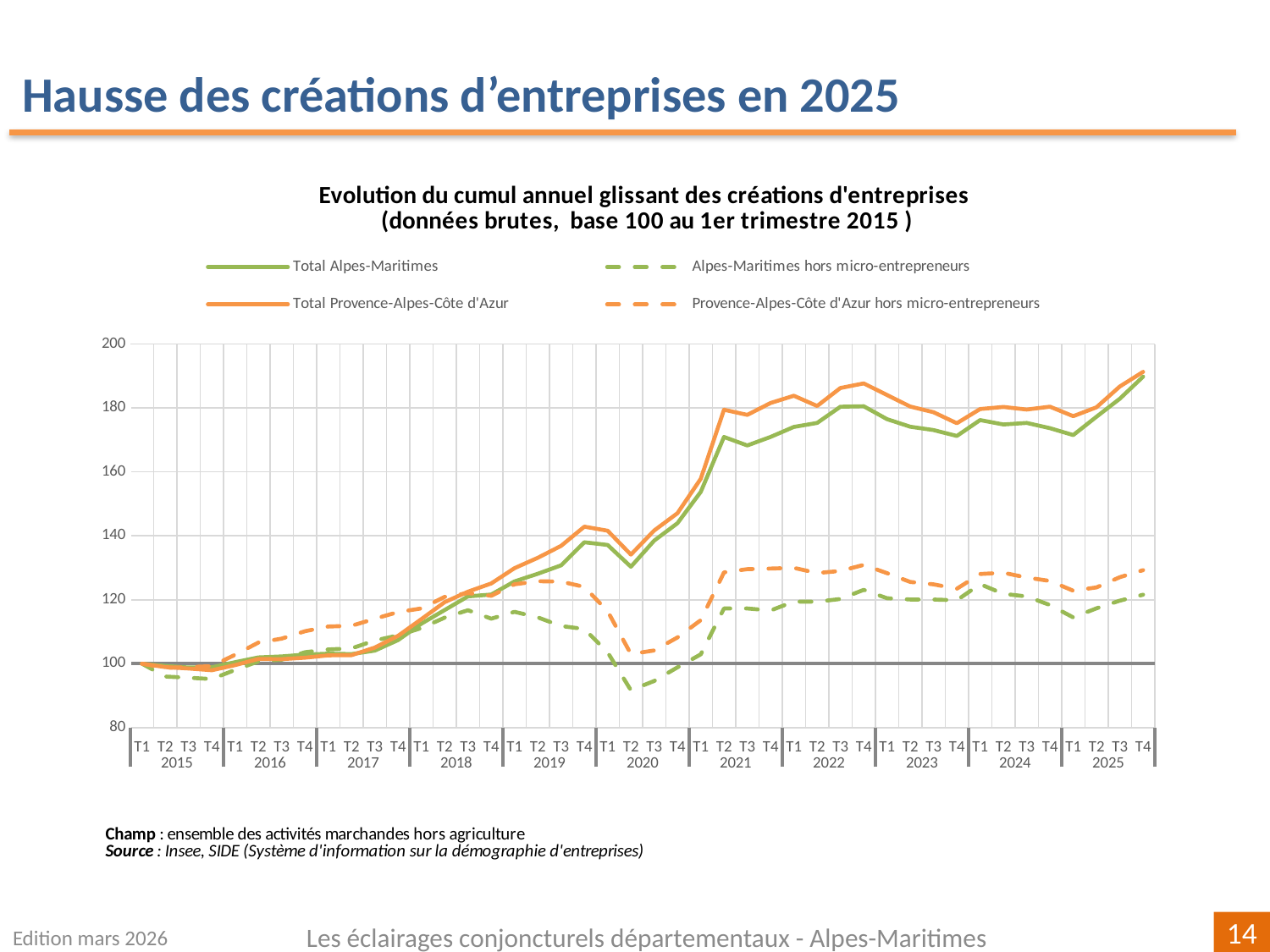
Is the value for Total Alpes-Maritimes at T1 2021 greater or less than 160? less What kind of chart is shown on the slide? line chart At T1 2022, which is larger: Total Provence-Alpes-Côte d'Azur or Total Alpes-Maritimes? Total Provence-Alpes-Côte d'Azur How many years are shown along the x axis? 11 Is the value for Alpes-Maritimes hors micro-entrepreneurs at T2 2020 greater or less than 100? less At T4 2025, which is larger: Total Alpes-Maritimes or Alpes-Maritimes hors micro-entrepreneurs? Total Alpes-Maritimes How many series does the legend list? 4 Is the value for Provence-Alpes-Côte d'Azur hors micro-entrepreneurs at T4 2025 greater or less than 120? greater Overall, does the Total Alpes-Maritimes series rise or fall from T1 2015 to T4 2025? rise According to the chart title, what is the base value at the 1st quarter of 2015? 100 Which two series are drawn with dashed lines? Alpes-Maritimes hors micro-entrepreneurs and Provence-Alpes-Côte d'Azur hors micro-entrepreneurs